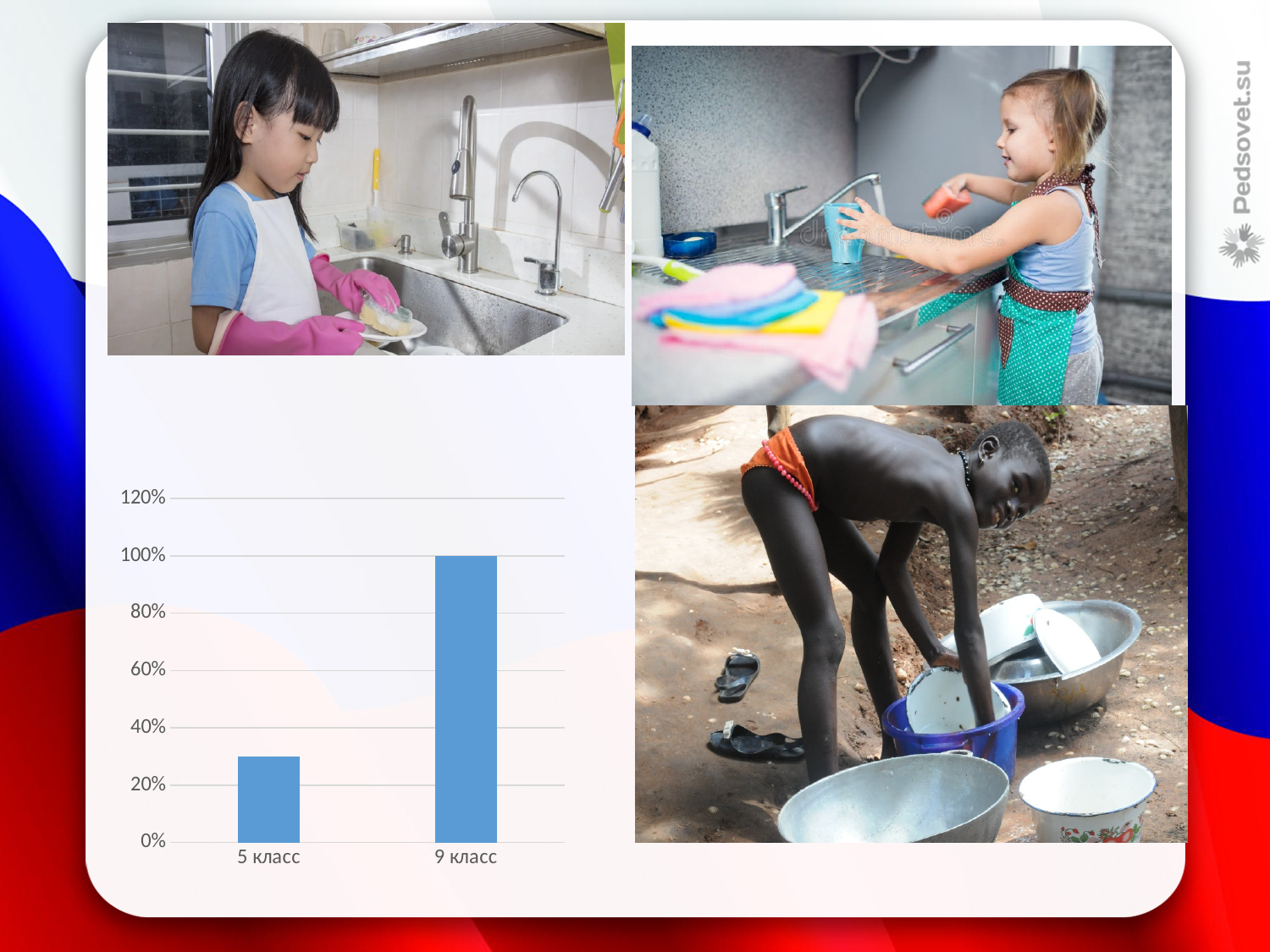
How many categories are shown on the x axis of the chart? 2 Which category has the highest value in the chart? 9 класс What colour are the bars in the chart? blue Do the values rise or fall from 5 класс to 9 класс? rise What is the highest value shown on the chart's vertical axis? 120% What is the value for 9 класс in the chart? 100% What kind of chart is shown on the slide? bar chart Is the value for 5 класс greater or less than 40%? less Which category has the lowest value in the chart? 5 класс Is the value for 5 класс greater or less than 20%? greater Is the value for 9 класс greater or less than 80%? greater Which is larger, the value for 5 класс or the value for 9 класс? 9 класс